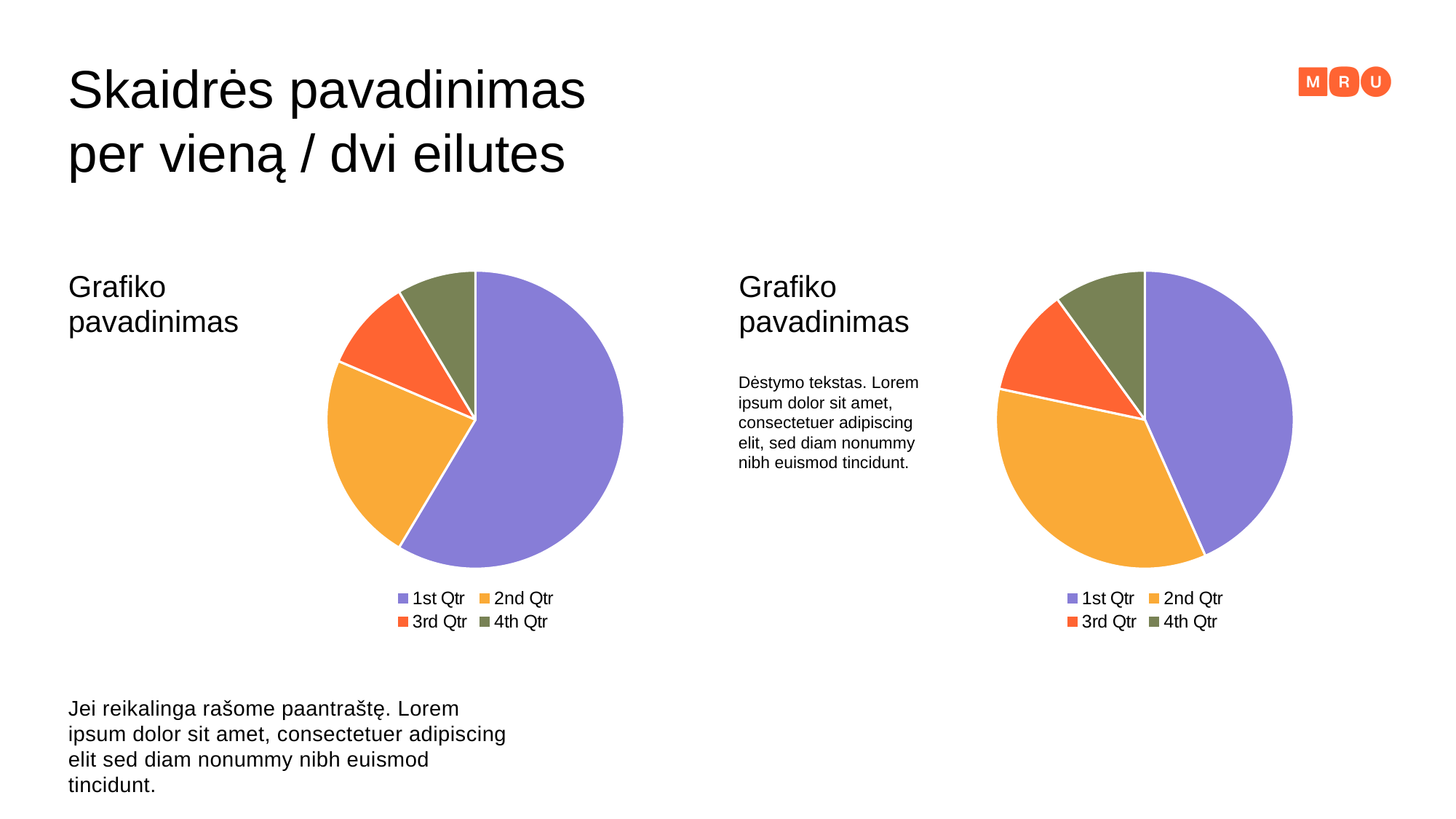
What kind of chart is the left chart on the slide? pie chart In the right pie chart, which slice is larger, 1st Qtr or 2nd Qtr? 1st Qtr In the right pie chart, how many entries does the legend list? 4 What is the title of the left chart? Grafiko pavadinimas In the left pie chart, which category has the largest slice? 1st Qtr In the right pie chart, which category has the largest slice? 1st Qtr In the left pie chart, which slice is larger, 1st Qtr or 4th Qtr? 1st Qtr In the right pie chart, which category is shown in orange-yellow? 2nd Qtr In the left pie chart, how many slices does the pie have? 4 In the left pie chart, which slice is larger, 2nd Qtr or 3rd Qtr? 2nd Qtr What kind of chart is the right chart on the slide? pie chart